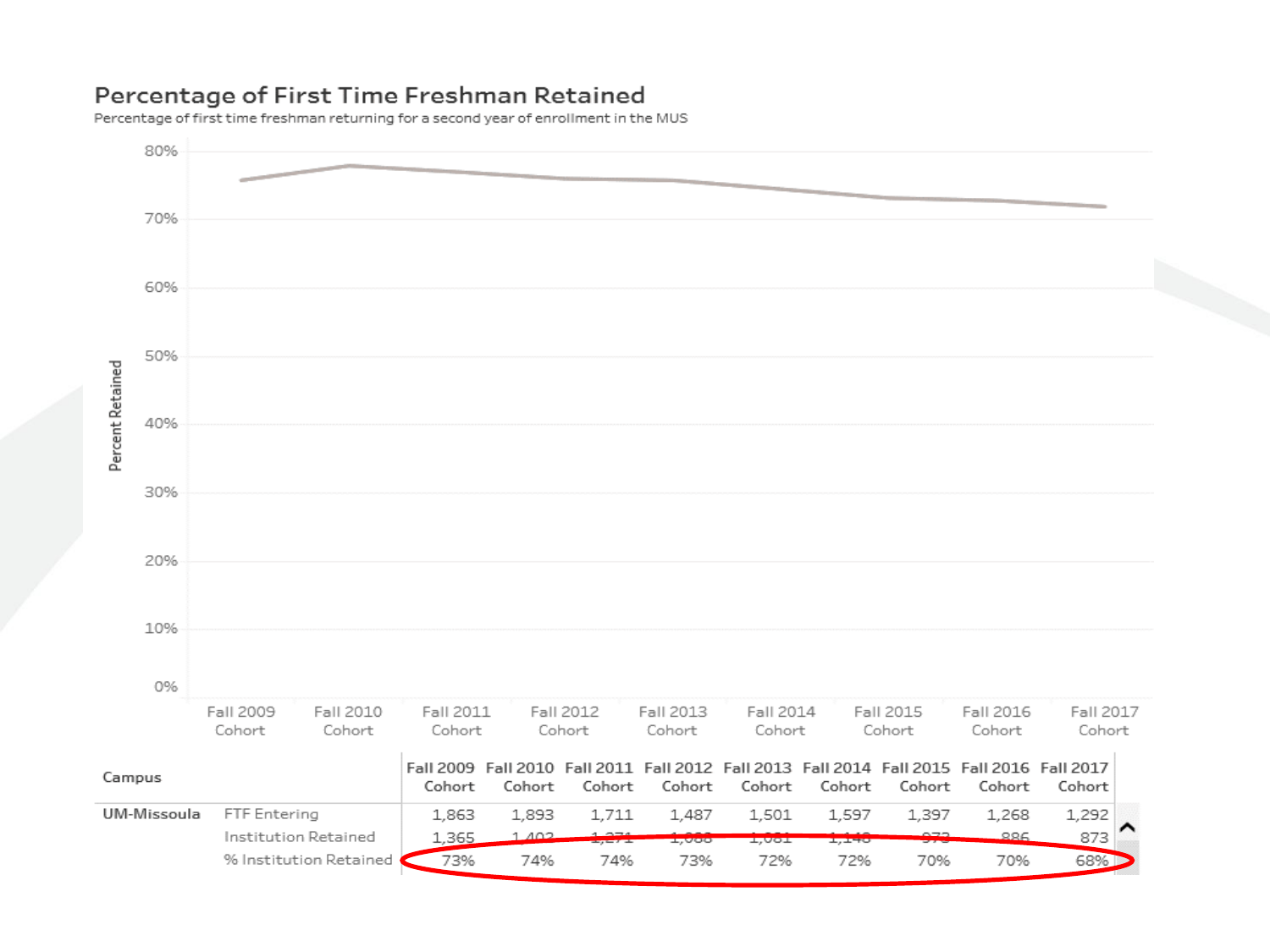
What kind of chart is shown on the slide? line chart In the table below the chart, what is the % Institution Retained for UM-Missoula for the Fall 2017 Cohort? 68% From the Fall 2010 Cohort to the Fall 2017 Cohort, does the plotted percent retained rise or fall? fall On the line chart, which is larger: the value for the Fall 2010 Cohort or the Fall 2014 Cohort? Fall 2010 Cohort In the table below the chart, what is the FTF Entering count for UM-Missoula for the Fall 2009 Cohort? 1,863 How many cohorts are plotted along the x axis of the line chart? 9 What is the label on the y axis of the line chart? Percent Retained Is the plotted value for the Fall 2009 Cohort greater or less than 70%? greater In the table below the chart, by how many percentage points does UM-Missoula's % Institution Retained for the Fall 2010 Cohort exceed that for the Fall 2017 Cohort? 6 percentage points Which cohort has the lowest point on the line chart? Fall 2017 Cohort Is the plotted value for the Fall 2010 Cohort greater or less than 80%? less Which cohort has the highest point on the line chart? Fall 2010 Cohort